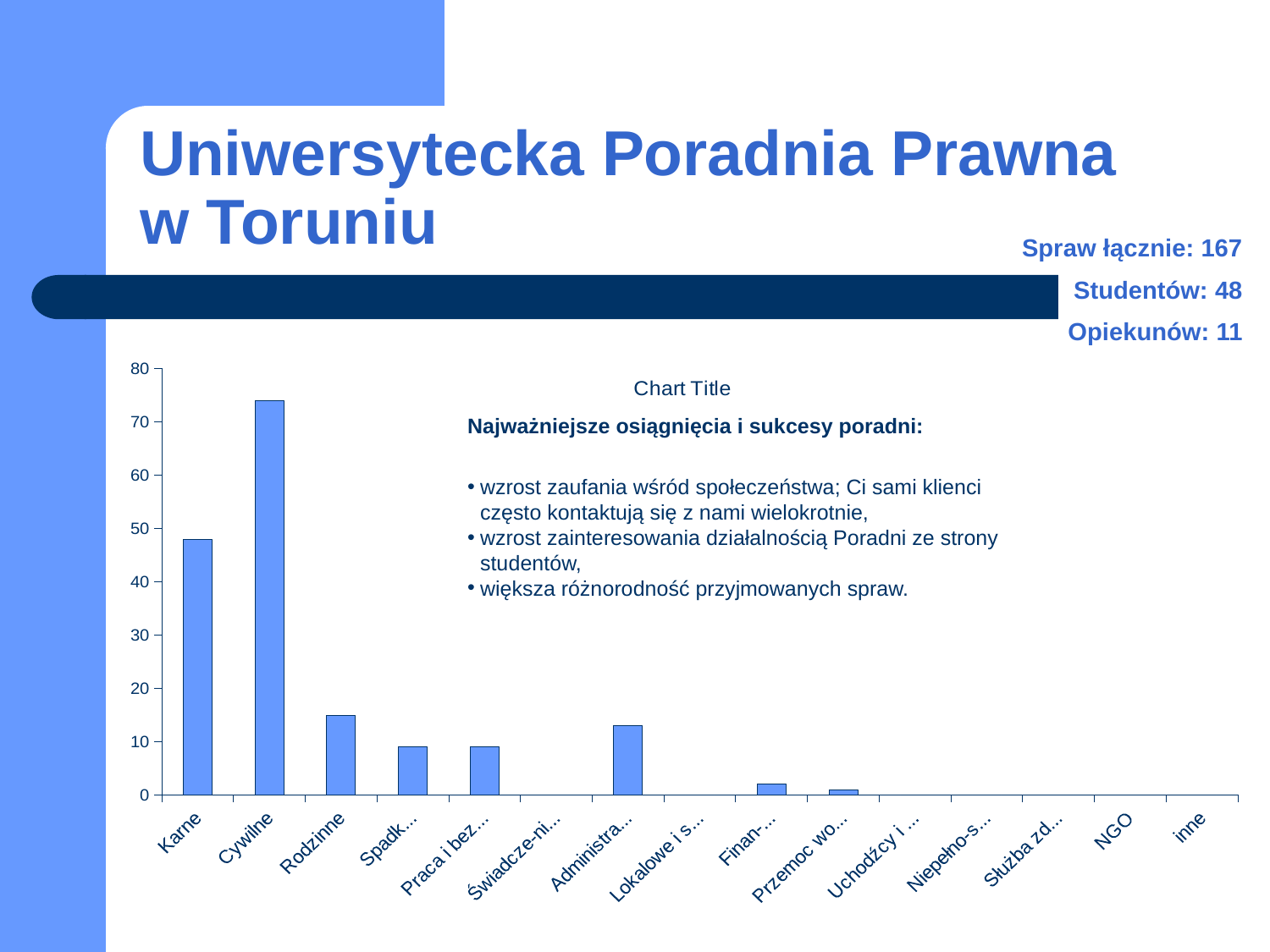
What title is displayed above the chart? Chart Title Is the value for Karne greater or less than 40? greater Is the value for Karne greater or less than 50? less What kind of chart is shown on the slide? bar chart Which is larger, the value for Rodzinne or the value for Spadk...? Rodzinne Is the value for Rodzinne greater or less than 10? greater Which category has the highest bar in the chart? Cywilne How many categories are shown on the x axis of the chart? 15 Which is larger, the value for Administra... or the value for Finan-...? Administra... Which is larger, the value for Karne or the value for Cywilne? Cywilne